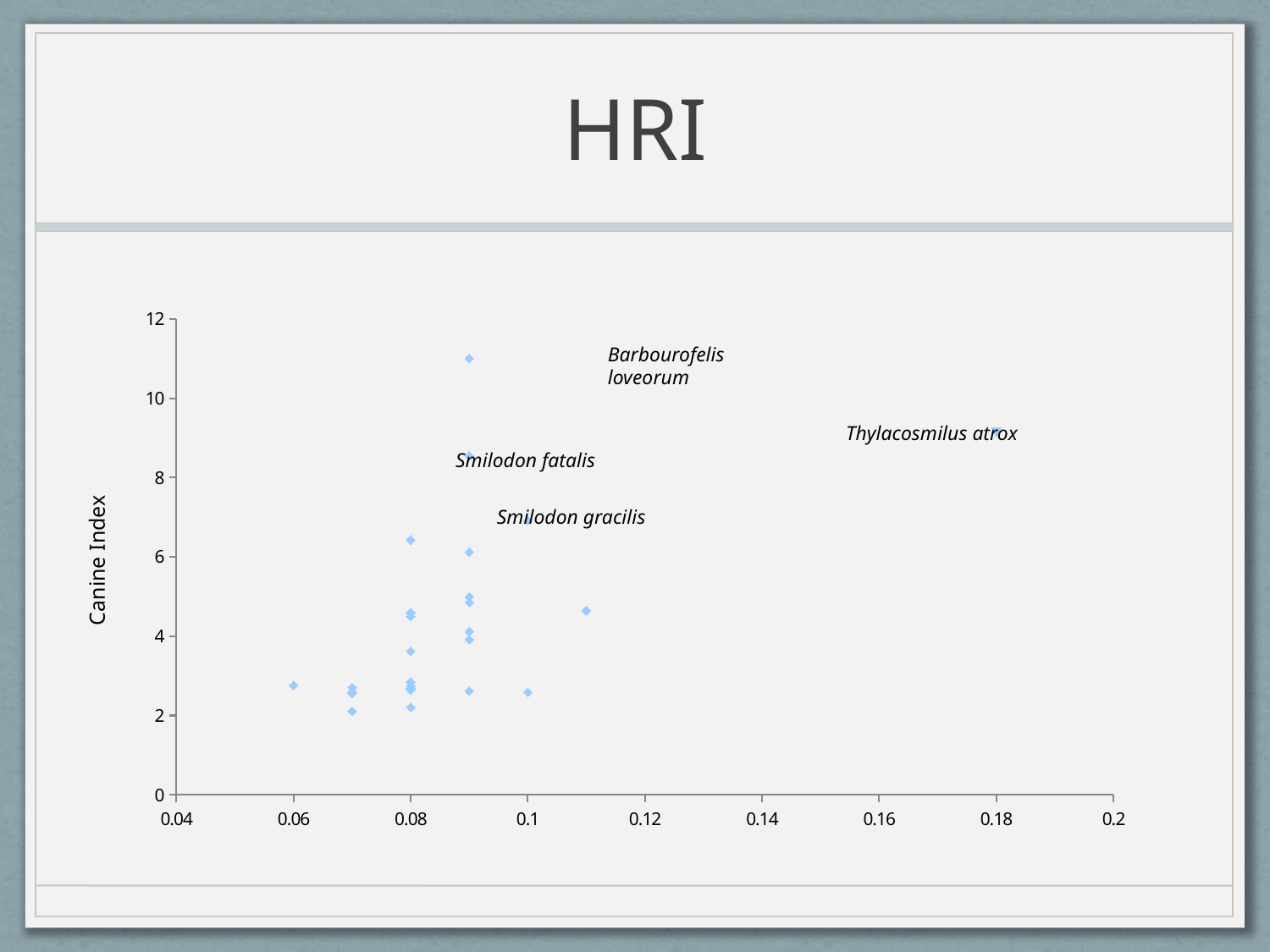
What is the title of the chart? HRI Is the Canine Index value for Smilodon fatalis greater or less than 10? less What is the label on the vertical axis of the chart? Canine Index Is the Canine Index value for Barbourofelis loveorum greater or less than 10? greater Is the horizontal-axis value for Thylacosmilus atrox greater or less than 0.16? greater Which has the higher Canine Index, Smilodon fatalis or Smilodon gracilis? Smilodon fatalis Of the four labeled species, which has the highest Canine Index? Barbourofelis loveorum How many species are labeled by name on the chart? 4 Which has the higher Canine Index, Barbourofelis loveorum or Thylacosmilus atrox? Barbourofelis loveorum What kind of chart is shown on the slide? scatter chart